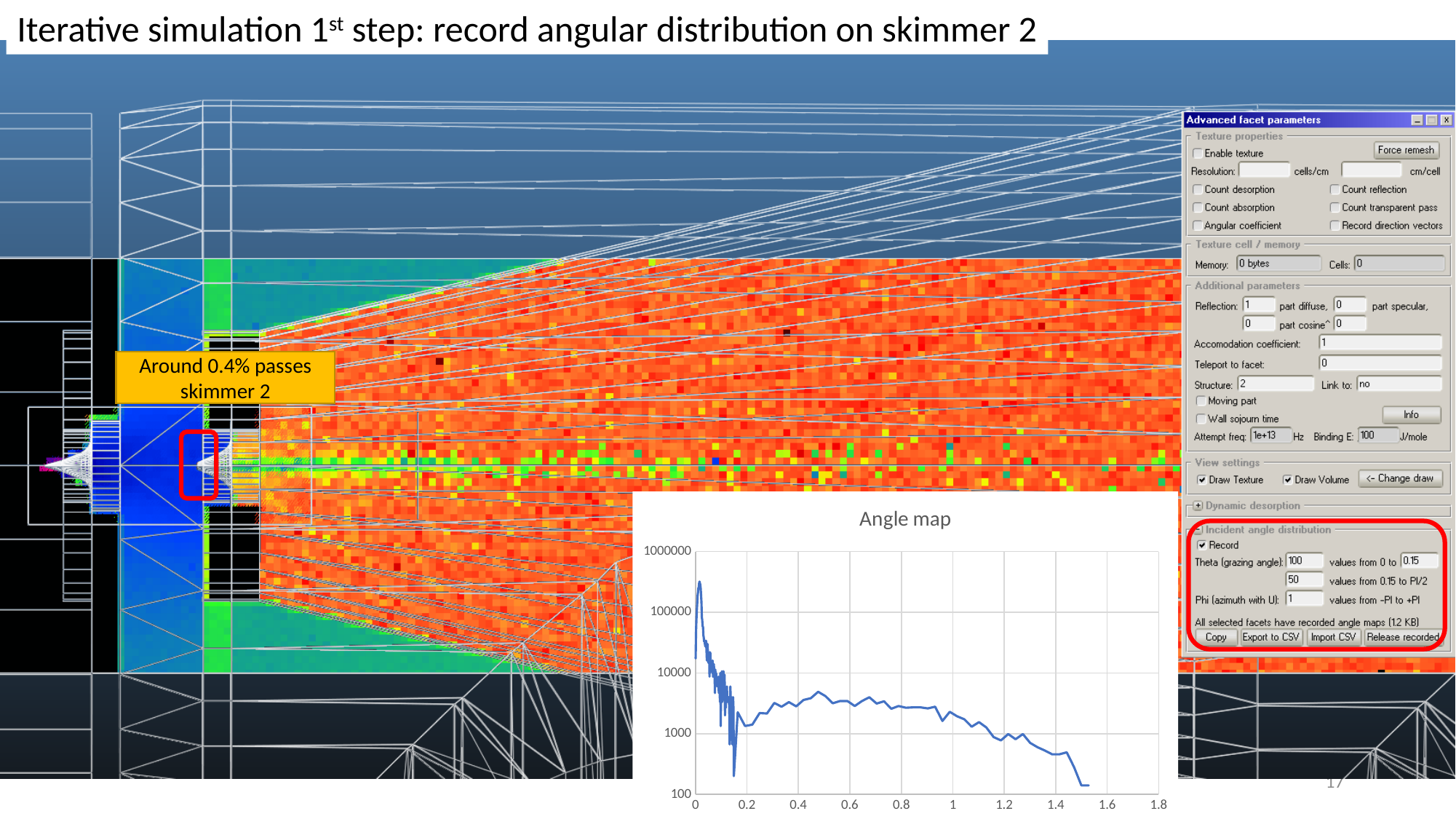
In the "Angle map" chart, is the value at x = 1.0 greater or less than 1000? greater In the "Angle map" chart, is the value at x = 0.6 greater or less than 10000? less How many series are plotted in the "Angle map" chart? 1 In the "Angle map" chart, do the values rise or fall along the x axis between x = 0.6 and x = 1.4? fall In the "Angle map" chart, is the peak value near x = 0 greater or less than 100000? greater What kind of chart is the "Angle map" chart? line chart What is the title of the chart on the slide? Angle map In the "Angle map" chart, is the value at x = 0.4 larger or smaller than the value at x = 1.4? larger What is the highest value shown on the y axis of the "Angle map" chart? 1000000